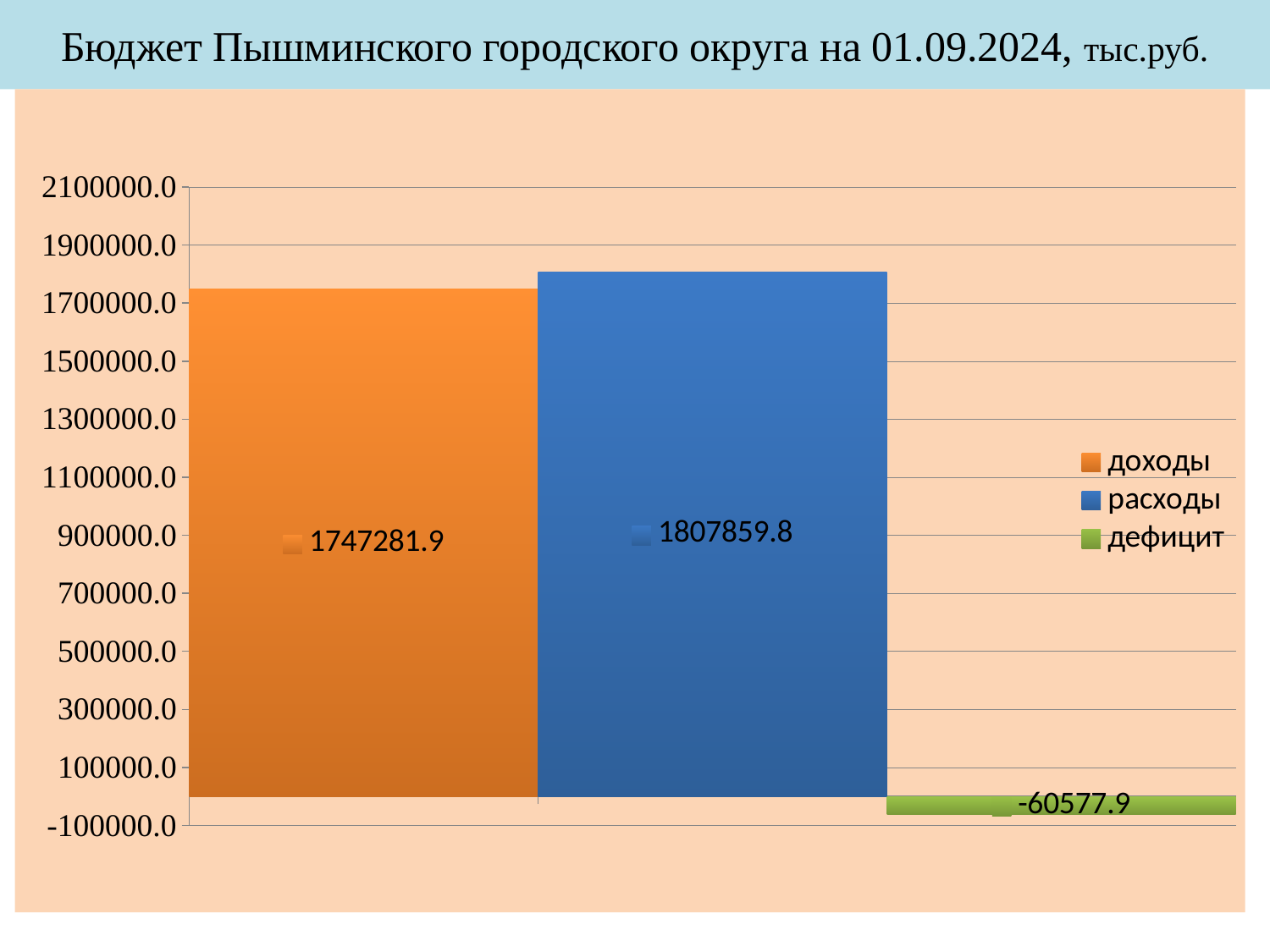
What is the difference between расходы and доходы? 60577.9 Which series has the lowest value? дефицит Is the value for доходы greater or less than 1700000.0? greater What kind of chart is shown on the slide? bar chart What is the title of the chart? Бюджет Пышминского городского округа на 01.09.2024, тыс.руб. Which is larger, доходы or расходы? расходы How many series does the legend list? 3 What is the value for расходы? 1807859.8 What is the value for дефицит? -60577.9 What is the value for доходы? 1747281.9 Is the value for расходы greater or less than 1900000.0? less Which series has the highest value? расходы